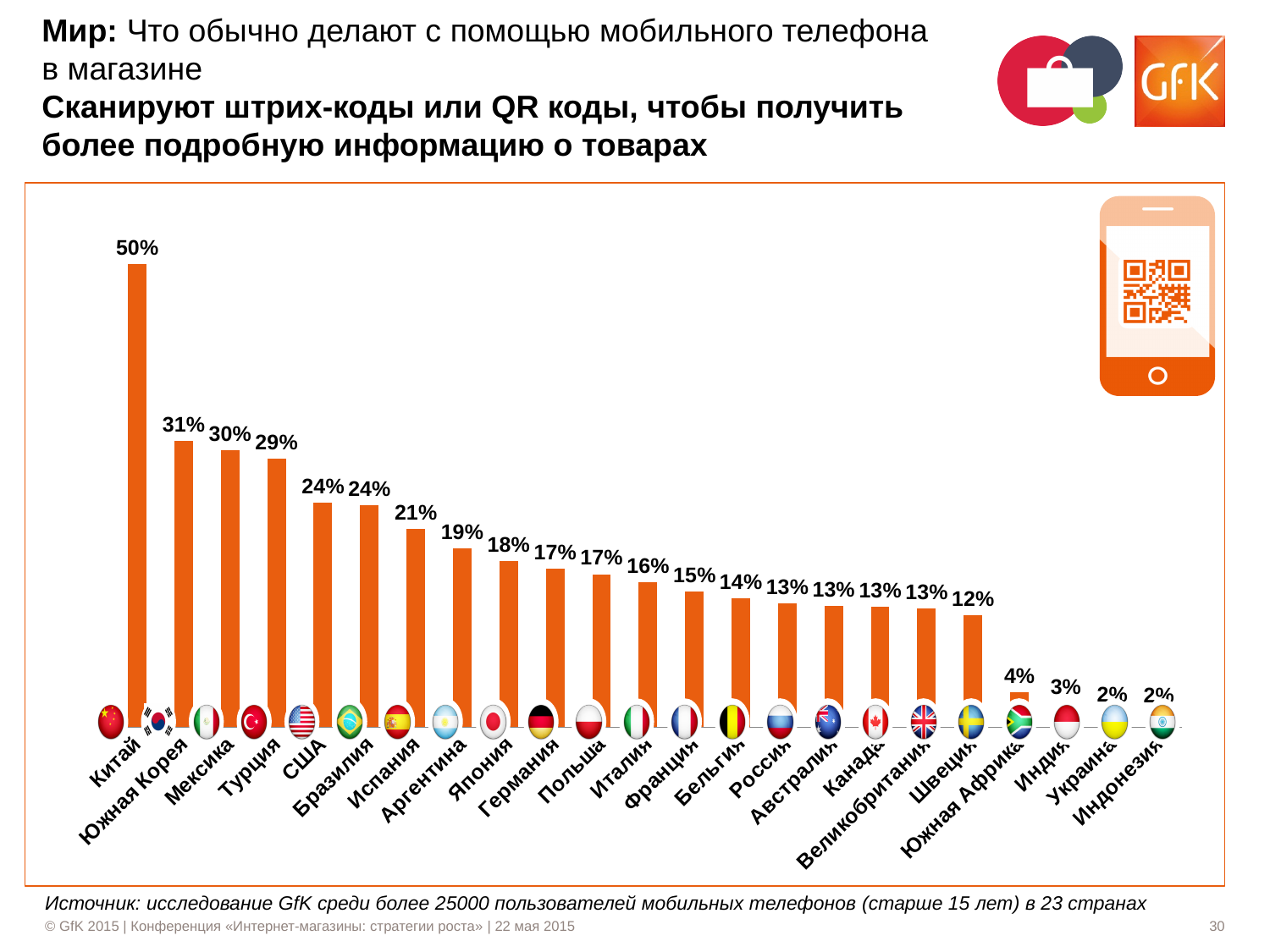
Do the values rise or fall from left to right along the x axis? Fall What is the difference between the values for Китай and Южная Корея? 19% How many countries are shown in the chart? 23 What is the difference between the values for Турция and Швеция? 17% Which is larger, the value for Мексика or the value for Испания? Мексика Which is larger, the value for Индия or the value for Южная Африка? Южная Африка Which country has the highest value? Китай What kind of chart is shown on the slide? Bar chart What is the value for Южная Африка? 4% What is the value for Россия? 13% What is the value for Япония? 18% What is the value for Китай? 50%